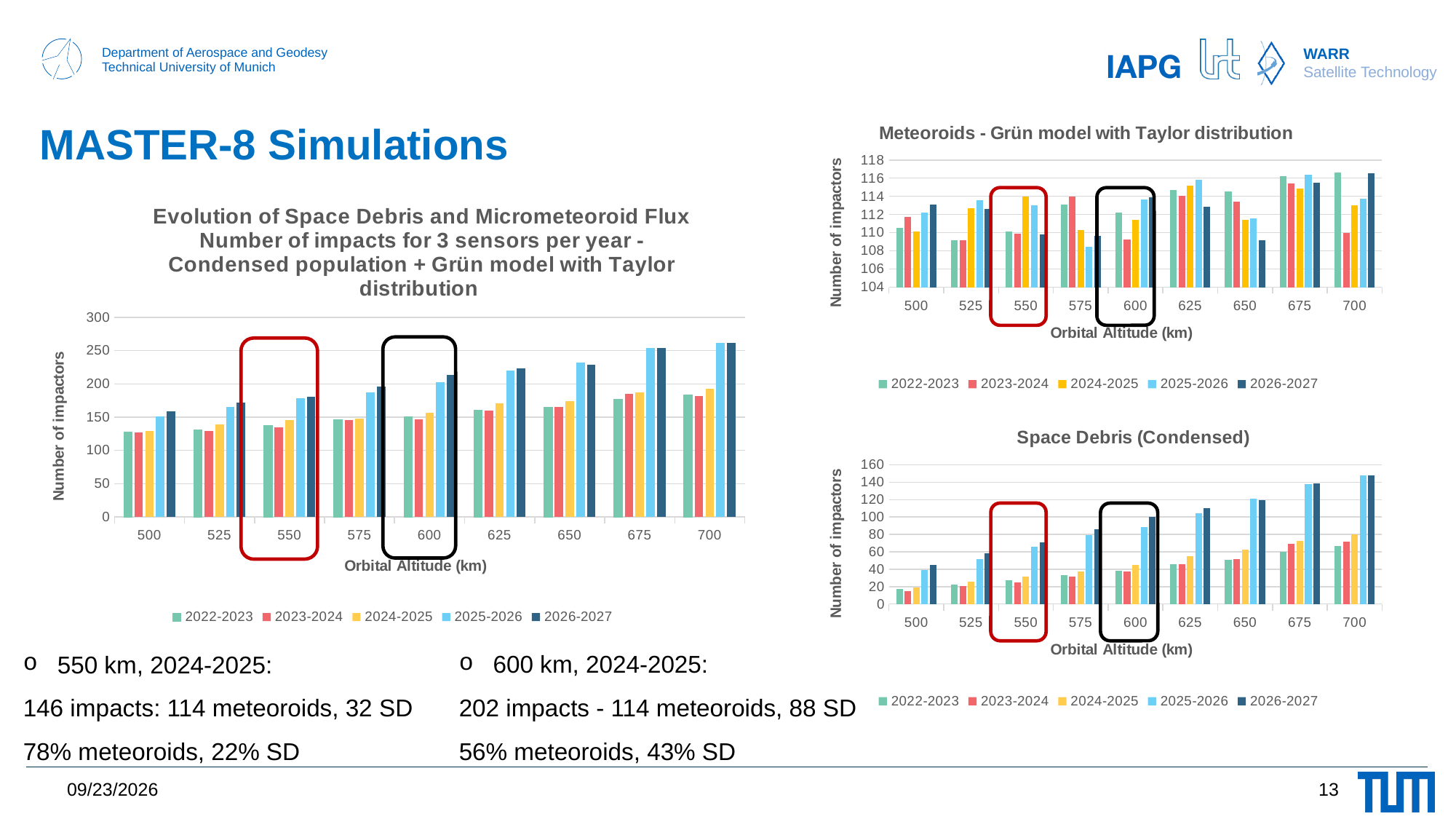
In the Space Debris (Condensed) chart, at which orbital altitude is the 2025-2026 bar highest? 700 What kind of chart is the large chart on the left of the slide? bar chart How many orbital altitude categories are shown on the x axis of the Space Debris (Condensed) chart? 9 In the Space Debris (Condensed) chart, do the 2025-2026 values rise or fall as orbital altitude increases from 500 to 700 km? rise In the Meteoroids - Grün model with Taylor distribution chart, is the 2022-2023 value at 500 km greater or less than 112? less In the Meteoroids - Grün model with Taylor distribution chart at 700 km, which is larger: the 2023-2024 value or the 2026-2027 value? 2026-2027 How many series does the legend of the left chart list? 5 In the left chart, is the 2022-2023 value at 500 km greater or less than 150? less Which two orbital altitudes are highlighted with red and black boxes on the charts? 550 and 600 In the Space Debris (Condensed) chart, is the 2026-2027 value at 600 km greater or less than 80? greater In the Space Debris (Condensed) chart at 650 km, which is larger: the 2025-2026 value or the 2022-2023 value? 2025-2026 In the left chart, at which orbital altitude is the 2026-2027 bar lowest? 500